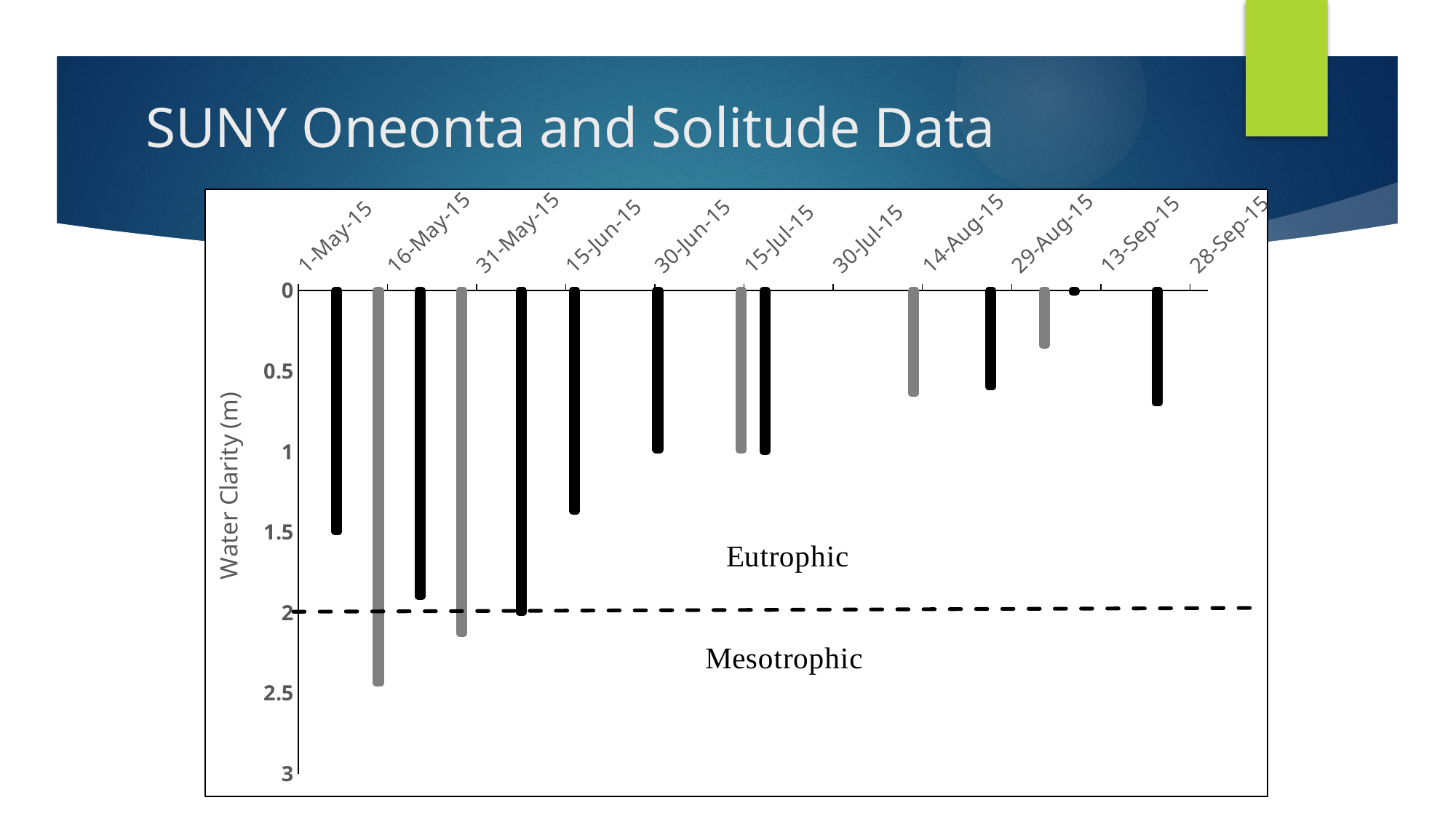
Is the water clarity value of the black bar just after 15-Jun-15 greater or less than 1? greater Is the water clarity value of the gray bar just after 1-May-15 greater or less than 2? greater How many date labels are shown along the horizontal axis? 11 What is the label on the vertical axis of the chart? Water Clarity (m) Is the water clarity value of the black bar at 1-May-15 greater or less than 1? greater What kind of chart is shown on the slide? bar chart Which bar reaches the greatest water clarity depth on the chart? the gray bar just after 1-May-15 Do the water clarity values generally rise or fall from May to September along the x axis? fall At what water clarity value is the dashed horizontal line separating Eutrophic and Mesotrophic drawn? 2